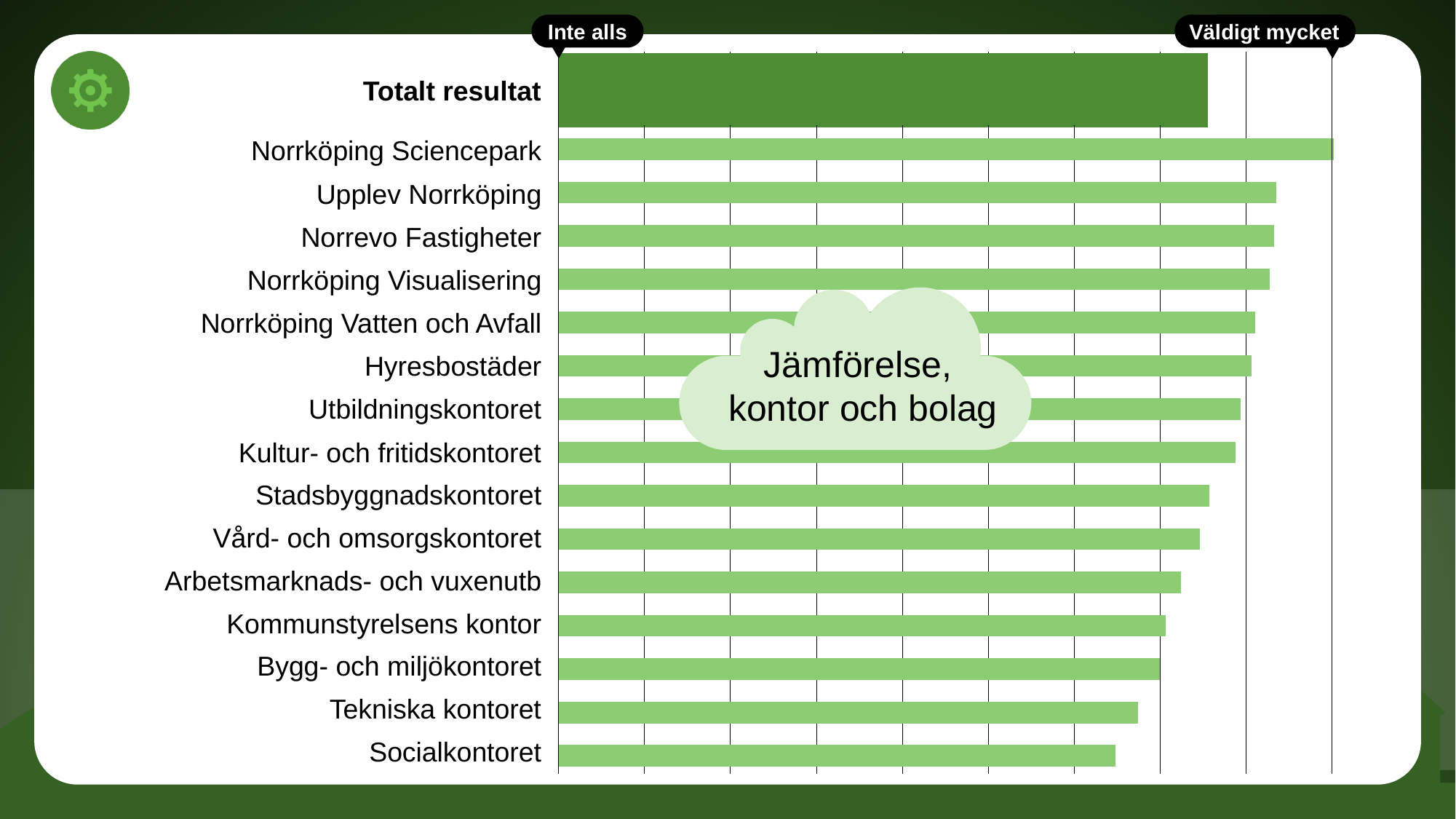
Which category has the shortest bar in the chart? Socialkontoret What kind of chart is shown on the slide? bar chart Which has the longer bar, Hyresbostäder or Bygg- och miljökontoret? Hyresbostäder Which has the longer bar, Stadsbyggnadskontoret or Kommunstyrelsens kontor? Stadsbyggnadskontoret How many bars are plotted in the chart, including Totalt resultat? 16 Which category has the longest bar in the chart? Norrköping Sciencepark Excluding Totalt resultat, how many kontor and bolag are listed in the chart? 15 Which has the longer bar, Tekniska kontoret or Socialkontoret? Tekniska kontoret What is the title shown in the cloud shape on the chart? Jämförelse, kontor och bolag What are the two labels at the ends of the chart's horizontal axis? Inte alls and Väldigt mycket